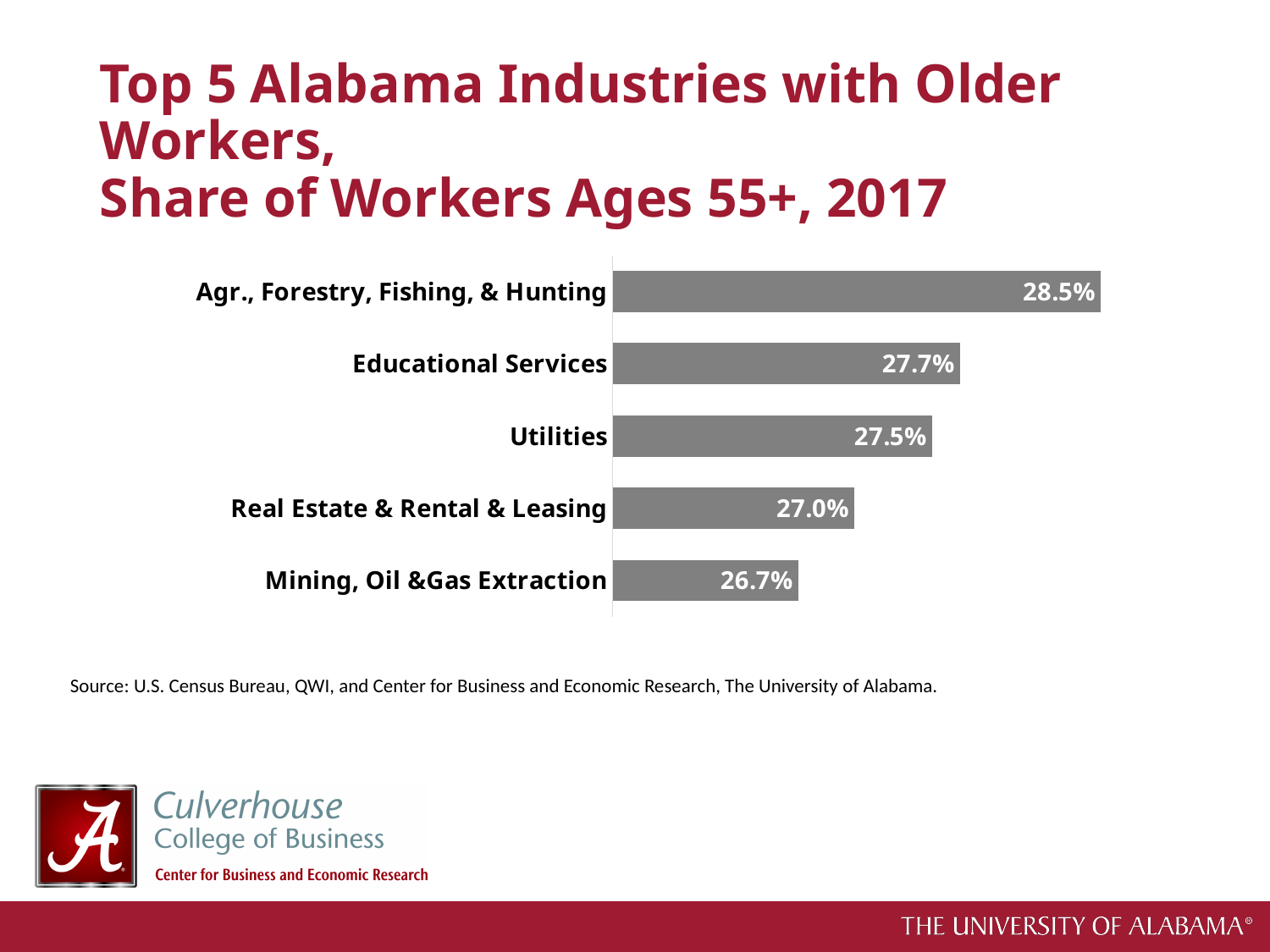
What is the difference in share of workers ages 55+ between Agr., Forestry, Fishing, & Hunting and Mining, Oil & Gas Extraction? 1.8 percentage points How many industries are shown in the chart? 5 What is the share of workers ages 55+ in Utilities? 27.5% What is the share of workers ages 55+ in Real Estate & Rental & Leasing? 27.0% Which has a larger share of workers ages 55+: Educational Services or Real Estate & Rental & Leasing? Educational Services Which industry has the lowest share of workers ages 55+? Mining, Oil & Gas Extraction Which industry has the highest share of workers ages 55+? Agr., Forestry, Fishing, & Hunting What is the share of workers ages 55+ in Agr., Forestry, Fishing, & Hunting? 28.5% What is the share of workers ages 55+ in Mining, Oil & Gas Extraction? 26.7% What is the share of workers ages 55+ in Educational Services? 27.7% What kind of chart is shown on the slide? Bar chart What year does the chart's data refer to? 2017